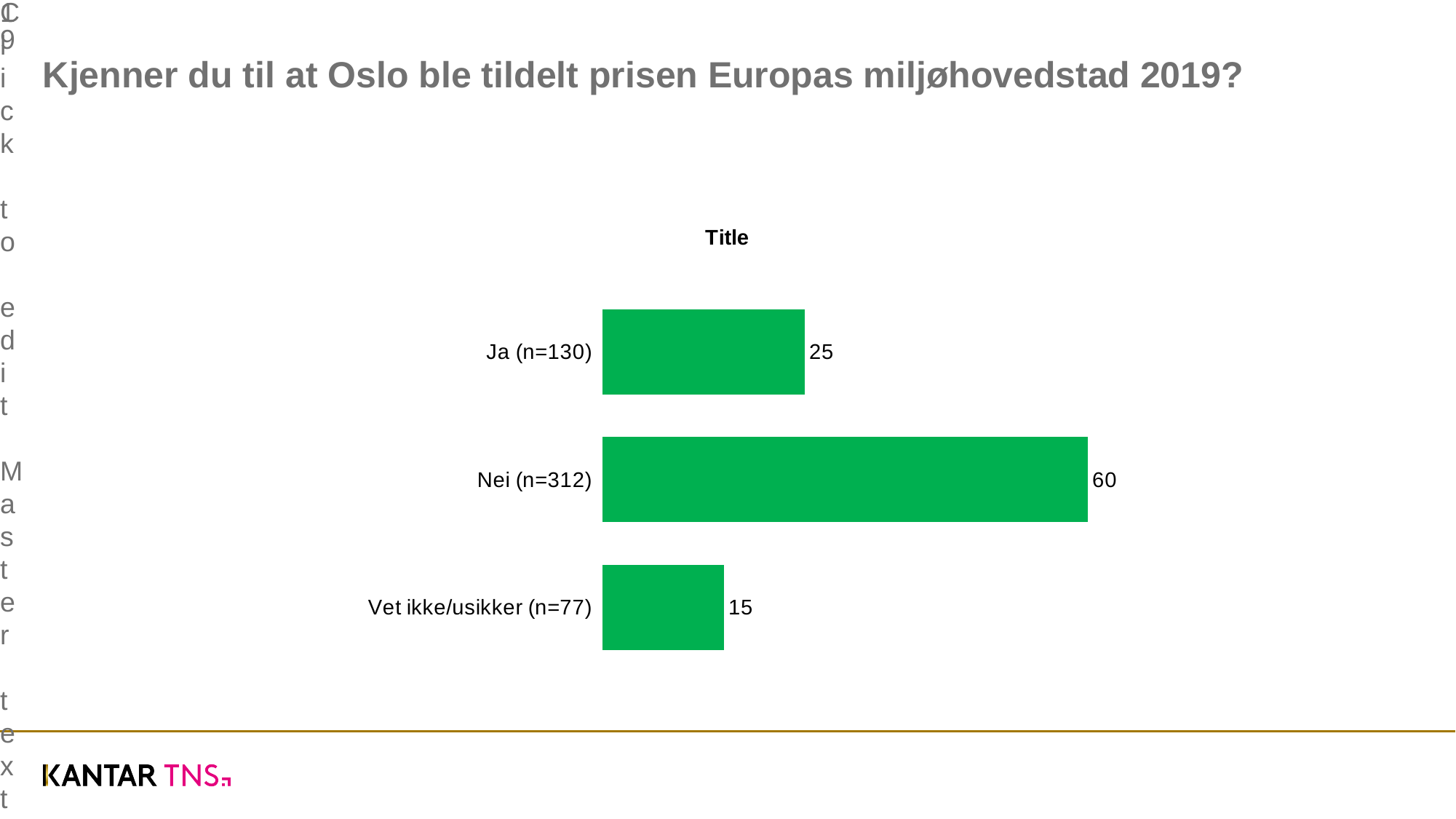
What is the title printed above the chart? Title What is the value for Ja (n=130)? 25 How many categories are shown in the chart? 3 Which is larger, the value for Ja (n=130) or the value for Vet ikke/usikker (n=77)? Ja (n=130) What is the value for Vet ikke/usikker (n=77)? 15 What is the value for Nei (n=312)? 60 Which category has the highest value? Nei (n=312) What is the difference between the values for Nei (n=312) and Ja (n=130)? 35 Which category has the lowest value? Vet ikke/usikker (n=77) What is the difference between the values for Ja (n=130) and Vet ikke/usikker (n=77)? 10 What colour are the bars in the chart? green What kind of chart is shown on the slide? bar chart